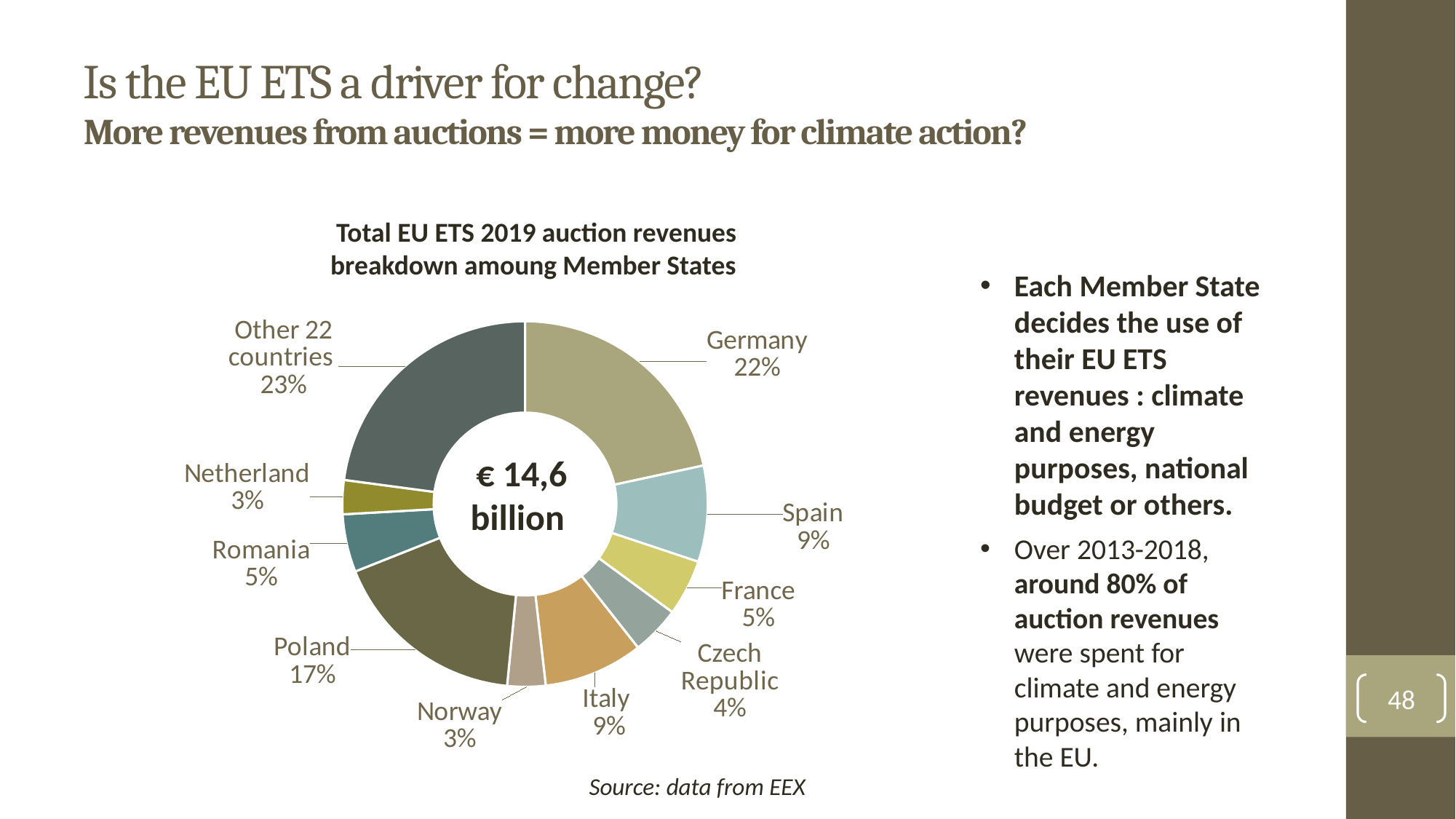
What percentage is shown for the Czech Republic? 4% What share of the revenues is attributed to the 'Other 22 countries' slice? 23% What total value is printed in the centre of the chart? € 14,6 billion What is the title of the chart? Total EU ETS 2019 auction revenues breakdown amoung Member States What share of the 2019 EU ETS auction revenues does Germany account for in the pie chart? 22% Which slice of the pie chart has the largest share? Other 22 countries What is the share shown for Spain? 9% What kind of chart is used to show the breakdown of auction revenues? Doughnut chart What percentage of the auction revenues is attributed to Poland? 17% By how many percentage points does Germany's share exceed Poland's share? 5 percentage points Which has a larger share of auction revenues, Poland or Spain? Poland How many slices does the pie chart have? 10